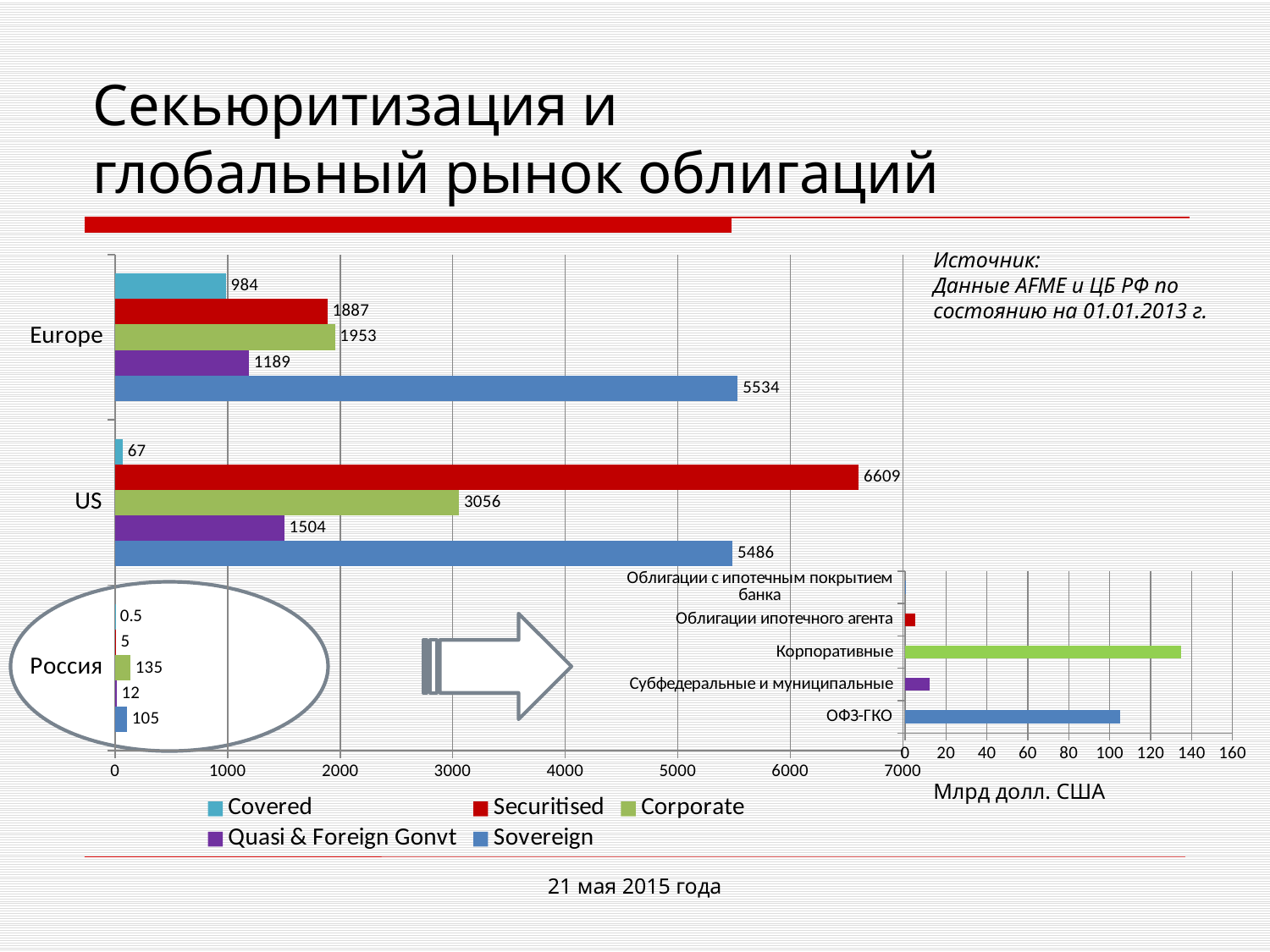
In the large bar chart on the left, what is the Corporate value for Россия? 135 In the large bar chart on the left, is the Sovereign value larger for Europe or for US? Europe In the small chart on the right, is the value for ОФЗ-ГКО greater or less than 80? greater In the large bar chart on the left, which series has the lowest value for Europe? Covered How many categories (regions) are shown in the large bar chart on the left? 3 In the large bar chart on the left, which series has the highest value for US? Securitised In the large bar chart on the left, what is the Sovereign value for Europe? 5534 In the large bar chart on the left, what is the Securitised value for US? 6609 How many series does the legend of the large bar chart on the left list? 5 In the small chart on the right, is the value for Корпоративные greater or less than 120? greater What kind of chart is the large chart on the left? bar chart In the large bar chart on the left, what is the difference between the Corporate and Securitised values for Europe? 66